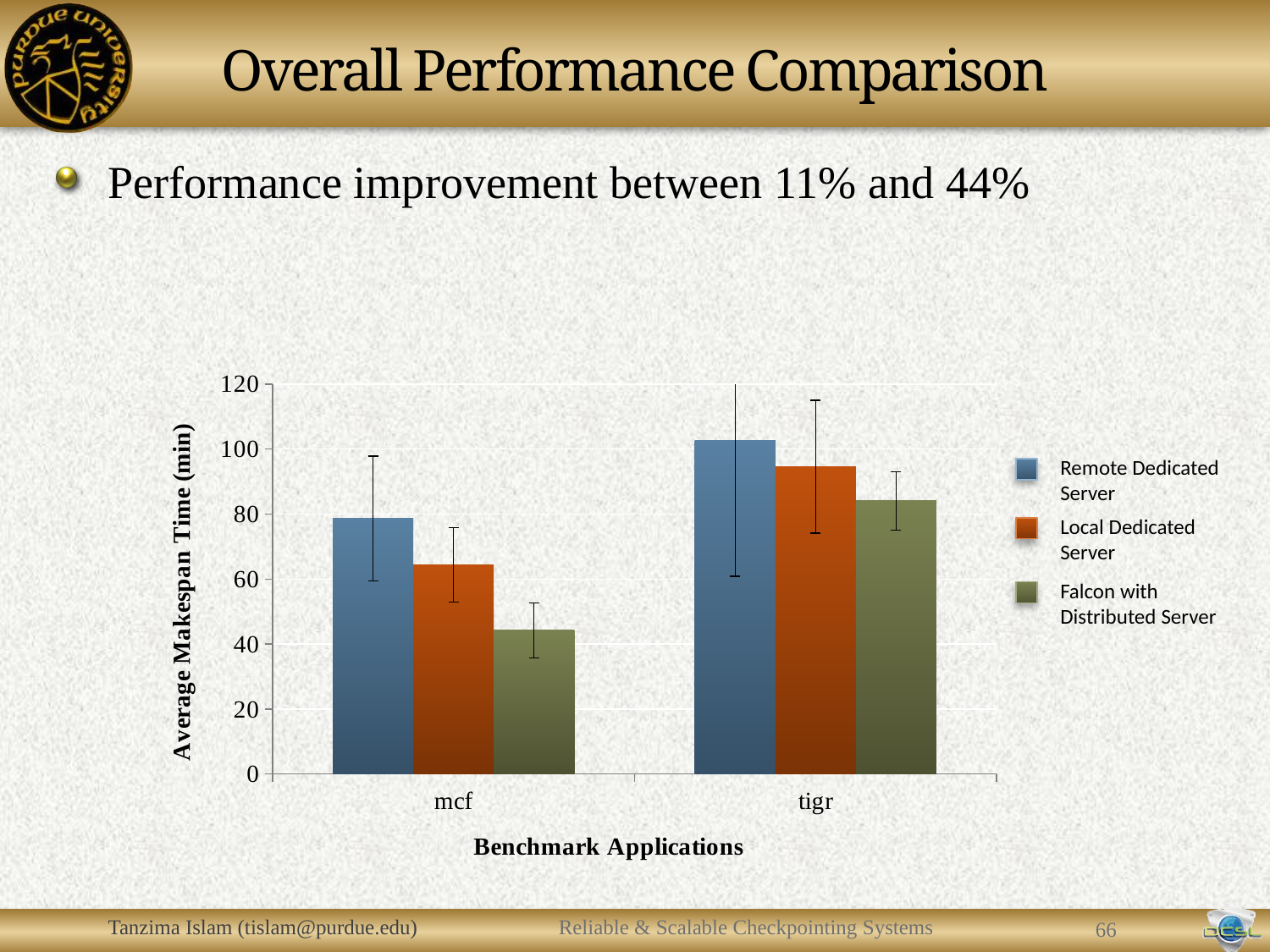
Is the Remote Dedicated Server value for mcf greater or less than 60? greater What kind of chart is shown on the slide? bar chart Is the Remote Dedicated Server value for tigr greater or less than 80? greater Which series has the lowest bar for mcf? Falcon with Distributed Server What is the label of the y axis? Average Makespan Time (min) Is the Falcon with Distributed Server value for mcf greater or less than 60? less For mcf, which is larger: Remote Dedicated Server or Falcon with Distributed Server? Remote Dedicated Server What is the label of the x axis? Benchmark Applications How many benchmark applications are shown on the x axis? 2 How many series does the legend list? 3 Which benchmark application has the highest Remote Dedicated Server bar? tigr